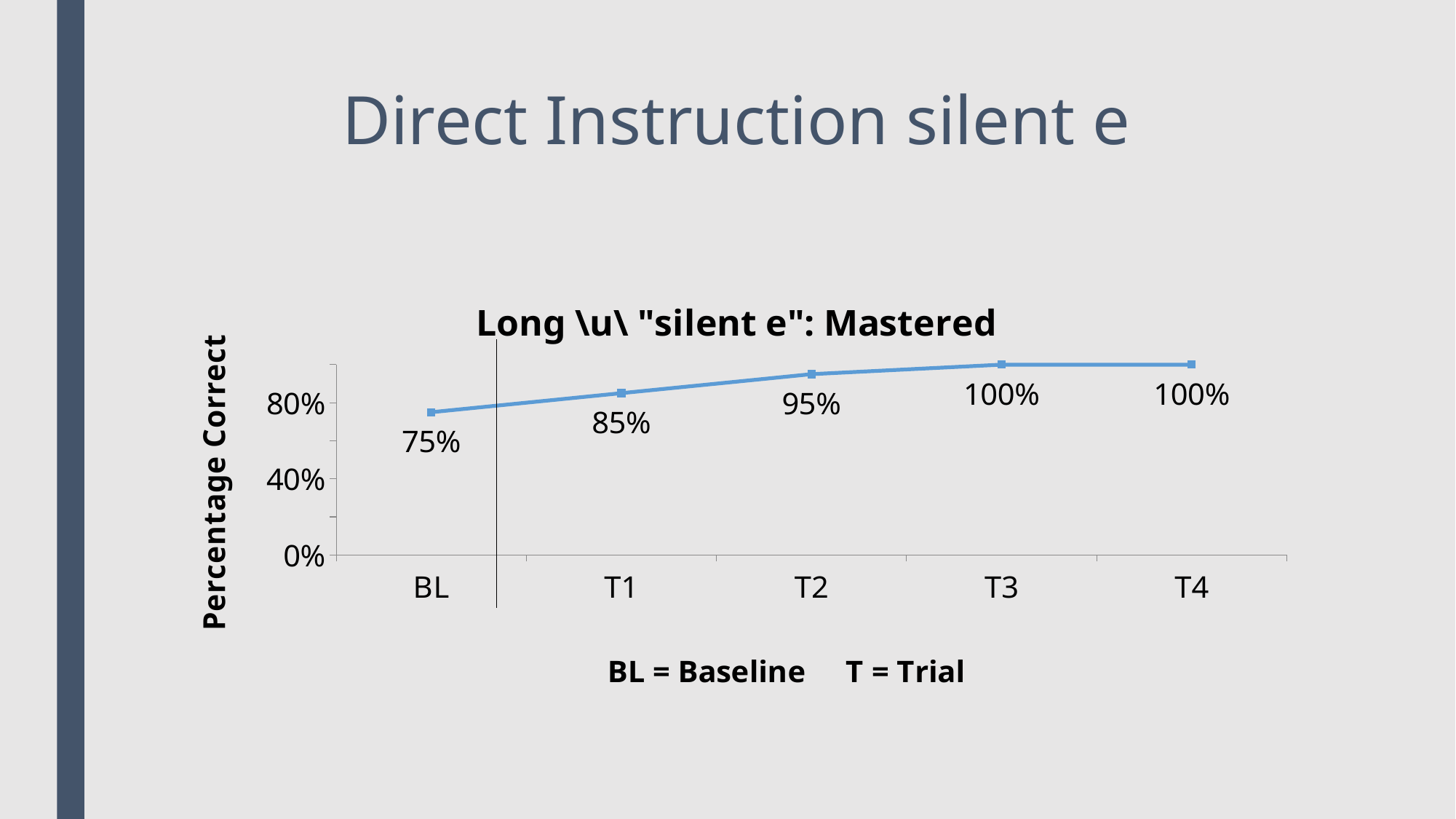
What is the difference in percentage correct between T3 and T2? 5% What is the difference in percentage correct between T1 and BL? 10% What is the percentage correct at BL? 75% What is the percentage correct at T2? 95% Do the values rise or fall from BL to T3? rise Which has a higher percentage correct, T1 or T2? T2 What is the percentage correct at T4? 100% Which point has the lowest percentage correct? BL What kind of chart is shown on the slide? line chart What is the title of the chart? Long \u\ "silent e": Mastered Is the value for BL greater or less than 40%? greater How many data points are plotted on the chart? 5